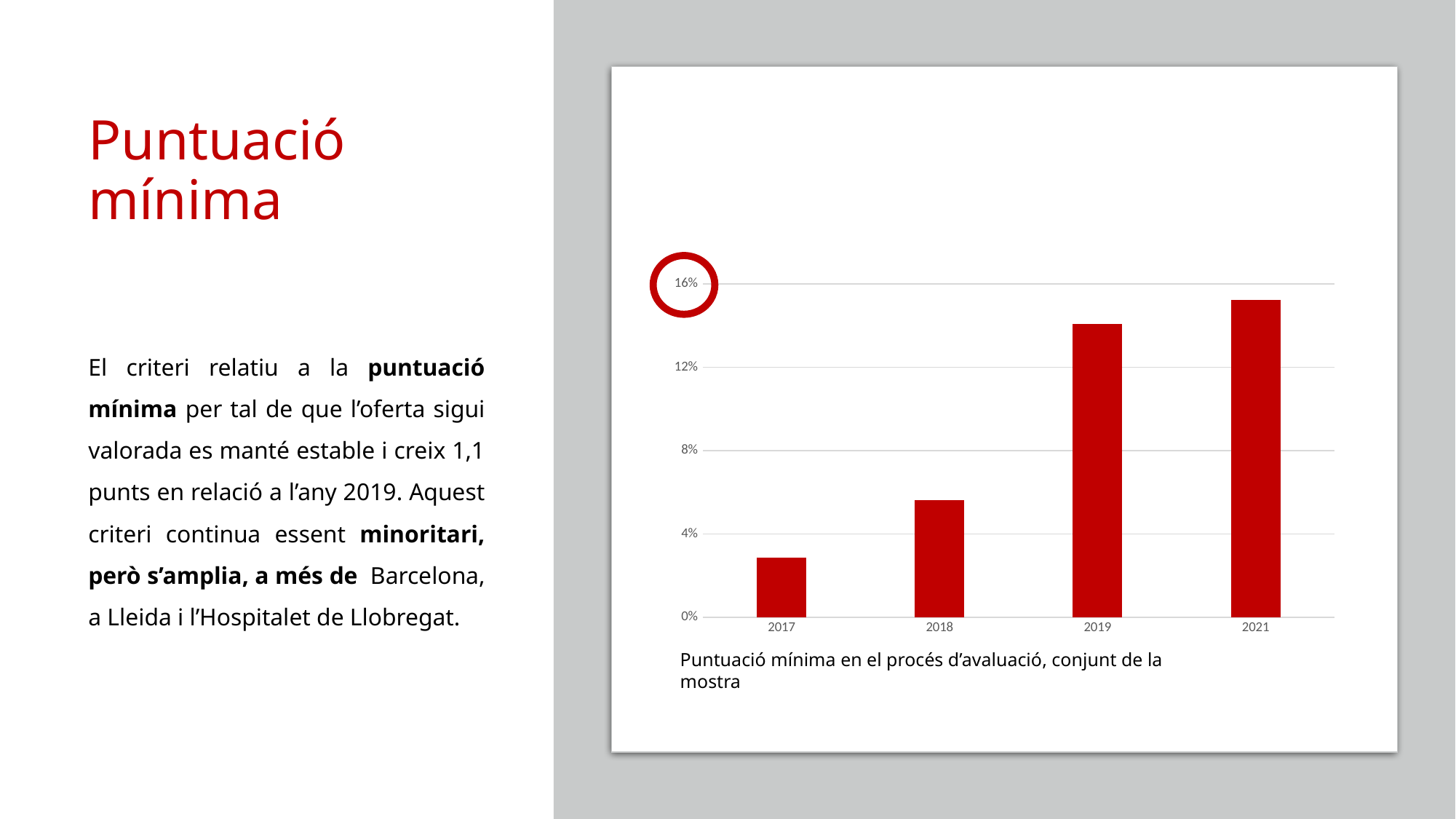
Do the values rise or fall from 2017 to 2021 in the chart? Rise Is the value for 2017 greater or less than 4%? less What colour are the bars in the chart? Red Which year has the lowest bar in the chart? 2017 What kind of chart is shown on the slide? Bar chart Is the value for 2018 greater or less than 4%? greater Which year has the highest bar in the chart? 2021 What is the caption printed below the chart? Puntuació mínima en el procés d'avaluació, conjunt de la mostra How many years are shown on the x axis of the chart? 4 Is the value for 2021 greater or less than 16%? less Which is larger, the value for 2018 or the value for 2019? 2019